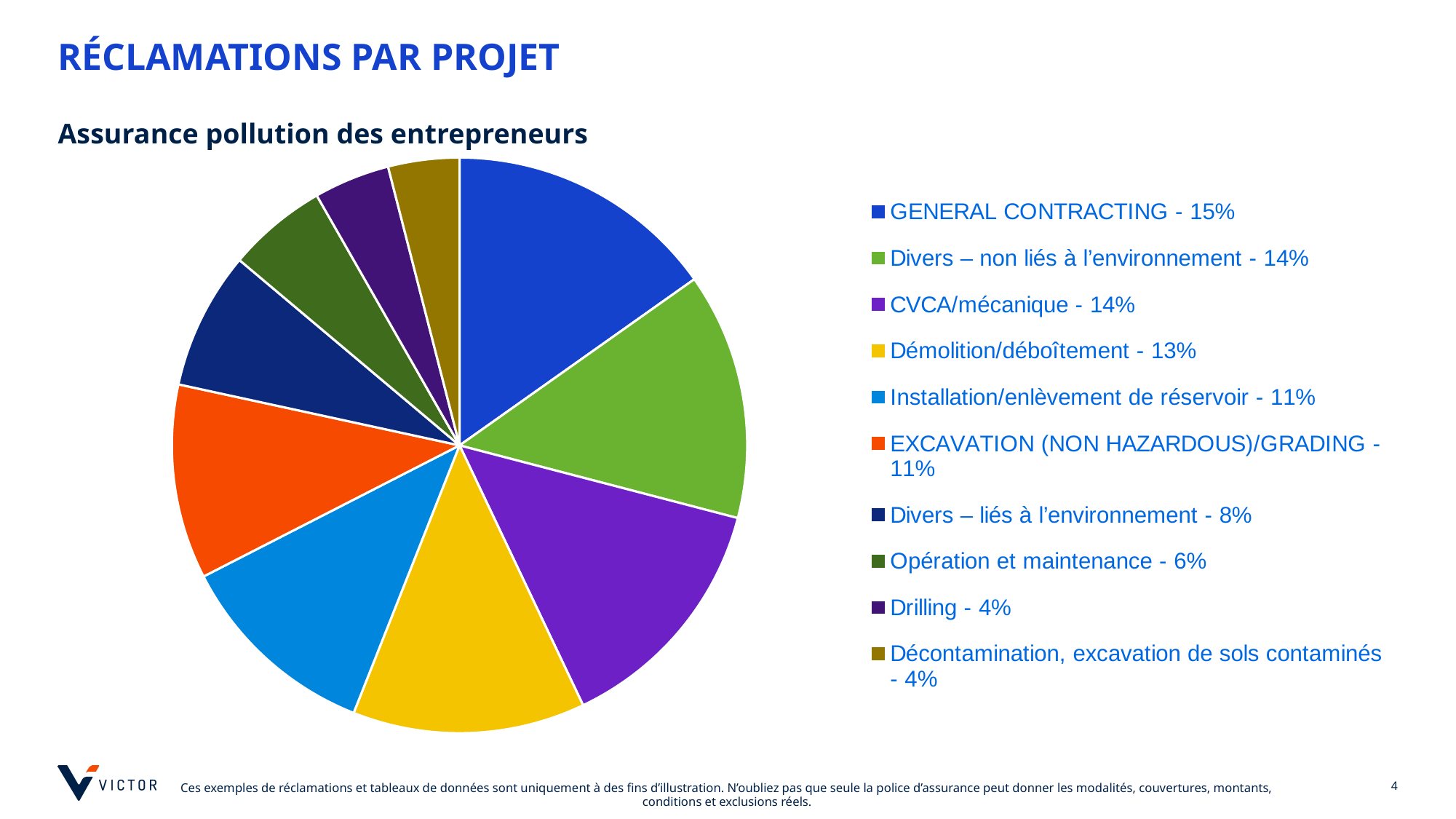
What is the difference in percentage points between GENERAL CONTRACTING and Drilling? 11 Which is larger, the share for CVCA/mécanique or the share for Divers – liés à l'environnement? CVCA/mécanique What is the combined share of Drilling and Décontamination, excavation de sols contaminés? 8% Which category has the largest share of the pie? GENERAL CONTRACTING What percentage is shown for Opération et maintenance? 6% What percentage is shown for Démolition/déboîtement? 13% What is the title of the slide containing the chart? RÉCLAMATIONS PAR PROJET What kind of chart is shown on the slide? pie chart What colour is the slice for EXCAVATION (NON HAZARDOUS)/GRADING? orange What percentage is shown for Installation/enlèvement de réservoir? 11% How many categories does the legend list? 10 What share of claims does GENERAL CONTRACTING account for? 15%